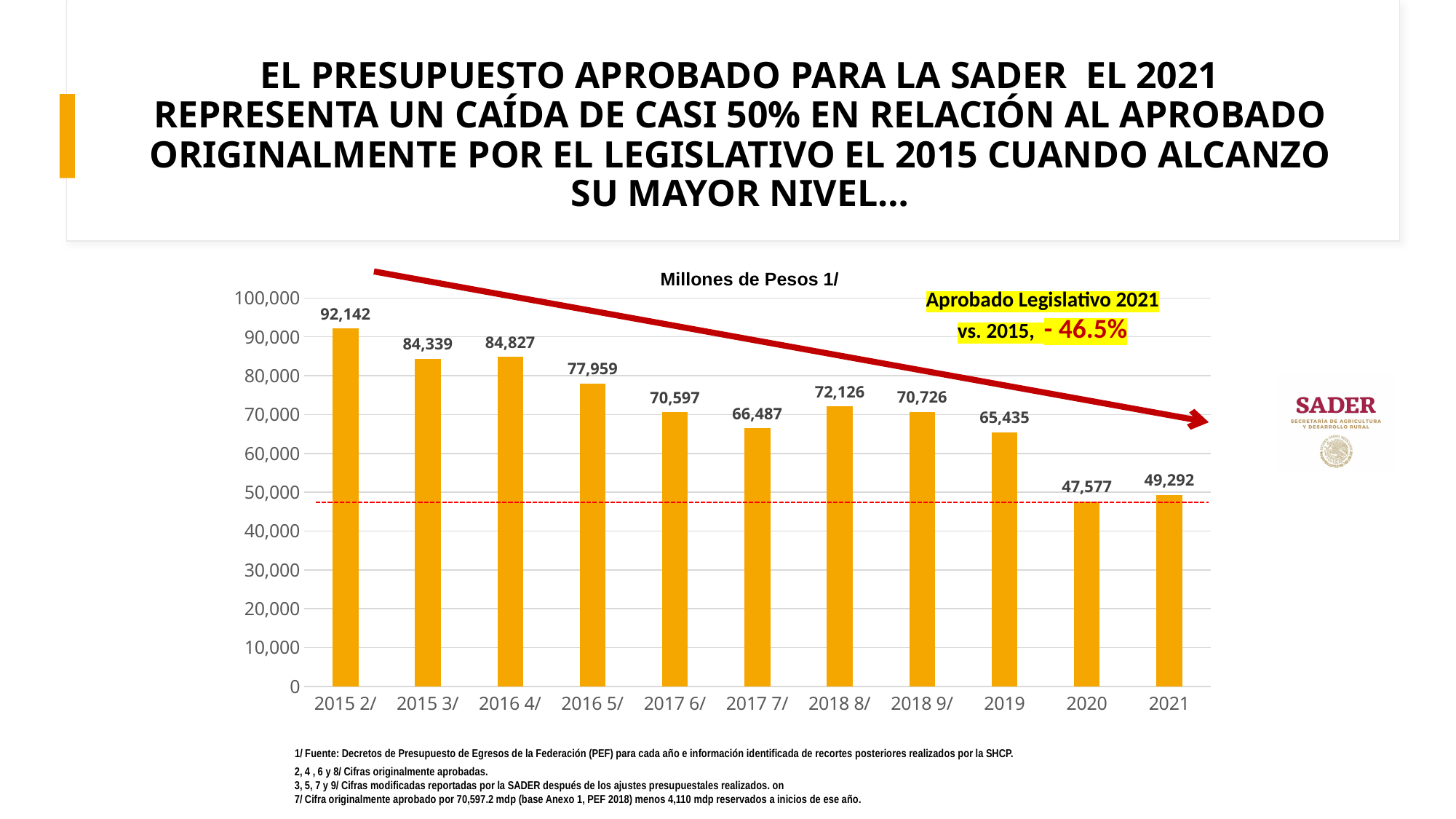
What is the value for 2021? 49,292 What is the value for 2020? 47,577 What is the value for 2017 7/? 66,487 Which category has the highest value? 2015 2/ Is the value for 2019 greater or less than 60,000? greater What kind of chart is shown on the slide? bar chart Which category has the lowest value? 2020 Which is larger, the value for 2018 8/ or the value for 2017 7/? 2018 8/ What is the title of the chart? Millones de Pesos 1/ What is the value for 2015 2/? 92,142 What is the difference between the values for 2015 2/ and 2021? 42,850 How many bars are shown in the chart? 11